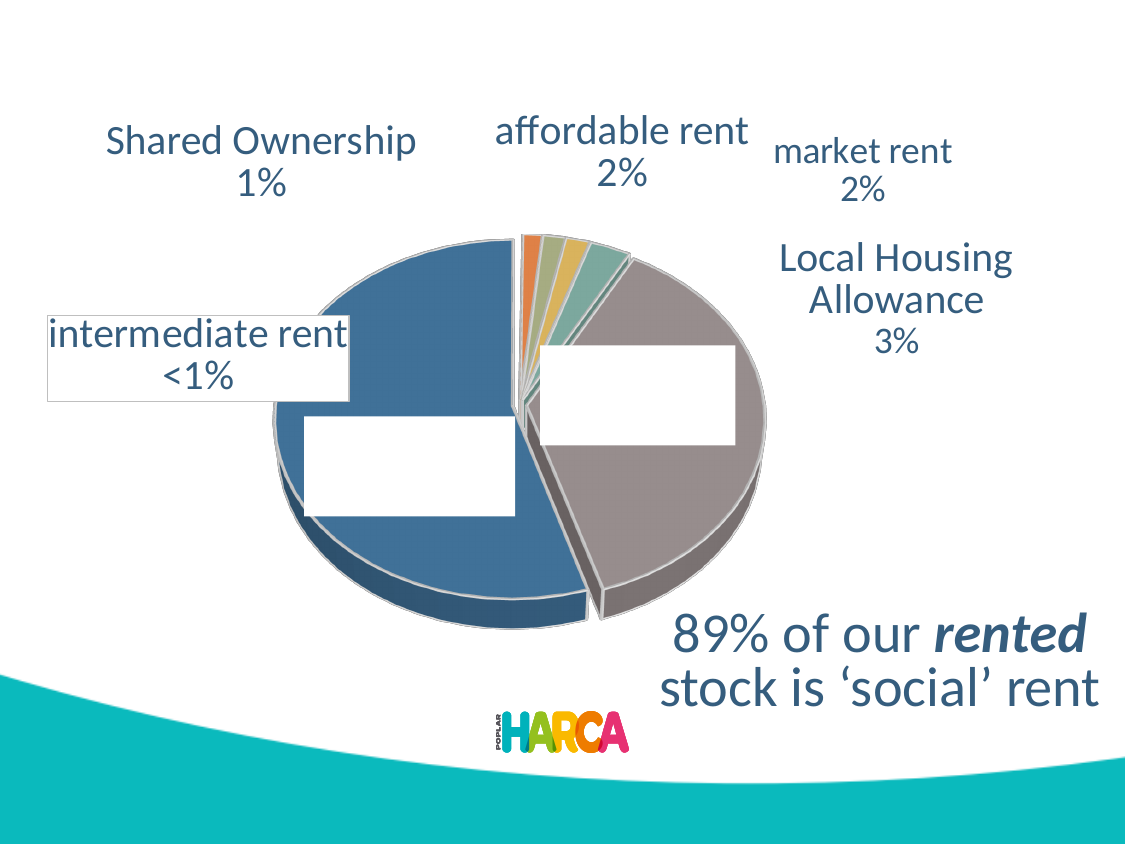
Among the labelled slices, which category has the highest percentage? Local Housing Allowance What kind of chart is shown on the slide? pie chart Among the labelled slices, which category has the lowest percentage? intermediate rent What percentage is shown for Local Housing Allowance? 3% What percentage is shown for market rent? 2% Which is larger, Local Housing Allowance or affordable rent? Local Housing Allowance According to the text on the slide, what percentage of the rented stock is 'social' rent? 89% What is the difference between the Local Housing Allowance percentage and the market rent percentage? 1% What value is shown for intermediate rent? <1% What percentage is shown for Shared Ownership? 1% What percentage is shown for affordable rent? 2%